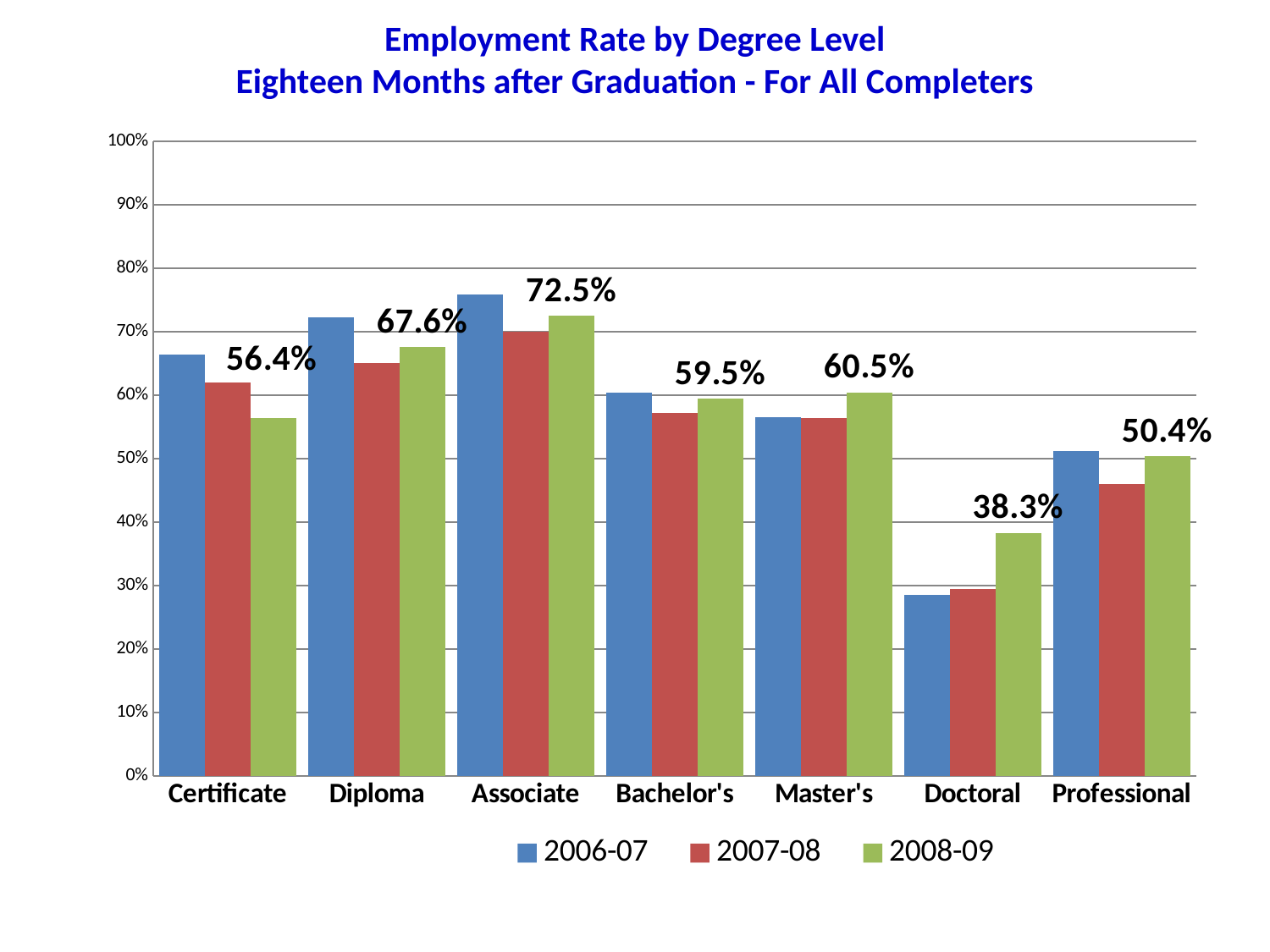
What kind of chart is shown on the slide? bar chart Which degree level has the lowest employment rate in the 2008-09 series? Doctoral How many degree levels are shown on the x axis? 7 What is the difference between the 2008-09 employment rates for Diploma and Bachelor's completers? 8.1 percentage points What is the employment rate for Doctoral completers in 2008-09? 38.3% Is the 2006-07 employment rate for Doctoral completers greater or less than 30%? less How many series does the legend list? 3 In 2008-09, which has the higher employment rate: Diploma or Bachelor's? Diploma Which degree level has the highest employment rate in the 2008-09 series? Associate What is the difference between the 2008-09 employment rates for Associate and Doctoral completers? 34.2 percentage points Is the 2007-08 employment rate for Professional completers greater or less than 50%? less What is the employment rate for Associate degree completers in 2008-09? 72.5%